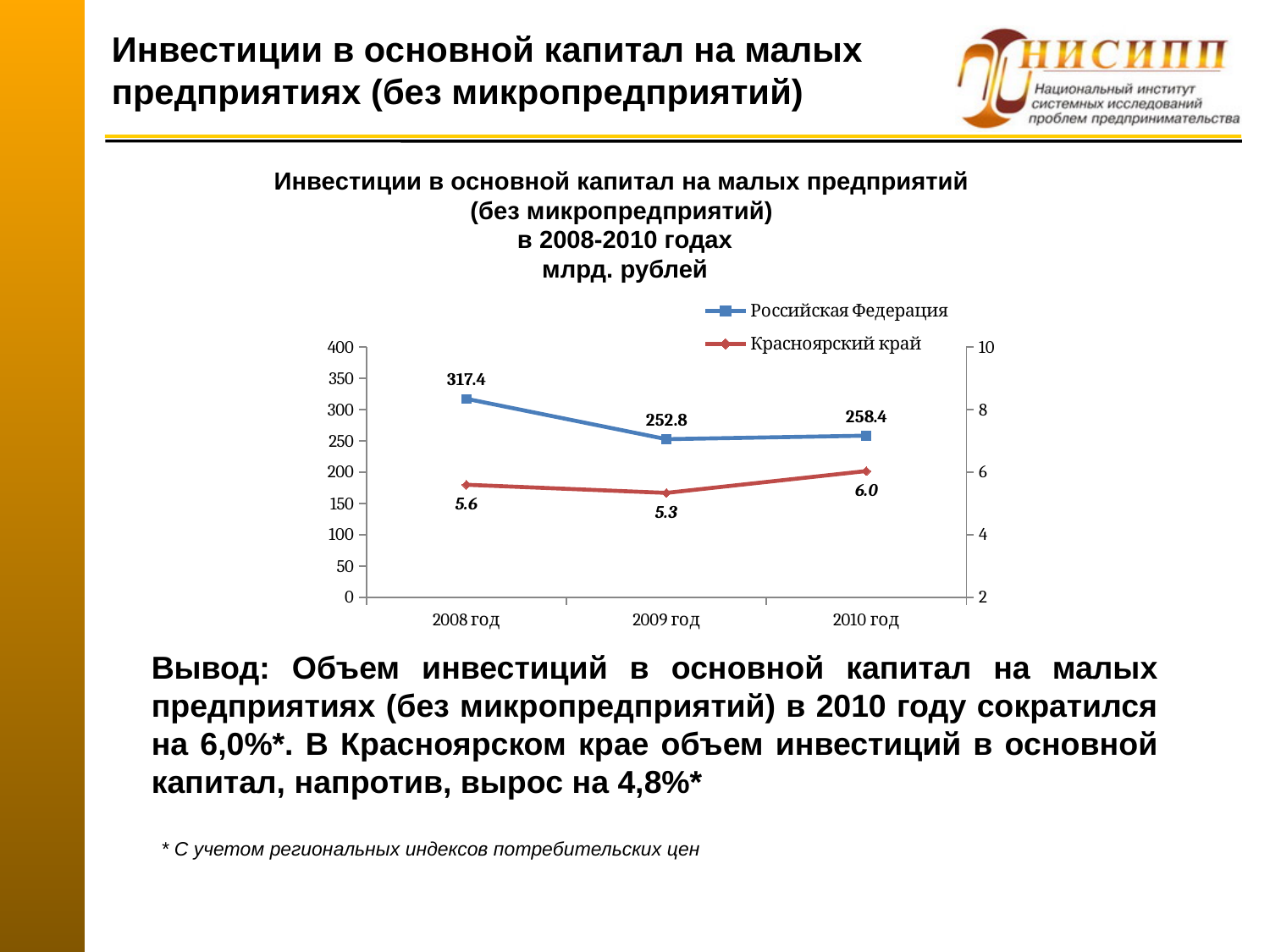
In which year is the value for Красноярский край lowest? 2009 год What is the value for Российская Федерация in 2009 год? 252.8 What is the value for Красноярский край in 2009 год? 5.3 What is the value for Красноярский край in 2010 год? 6.0 In which year is the value for Российская Федерация highest? 2008 год What is the value for Российская Федерация in 2008 год? 317.4 Does the value for Российская Федерация rise or fall from 2008 год to 2009 год? Fall Which is larger for Красноярский край: the value in 2008 год or in 2010 год? 2010 год How many years are shown on the x axis? 3 What type of chart is shown on the slide? Line chart How many series does the legend list? 2 What is the difference between the Российская Федерация values for 2008 год and 2009 год? 64.6